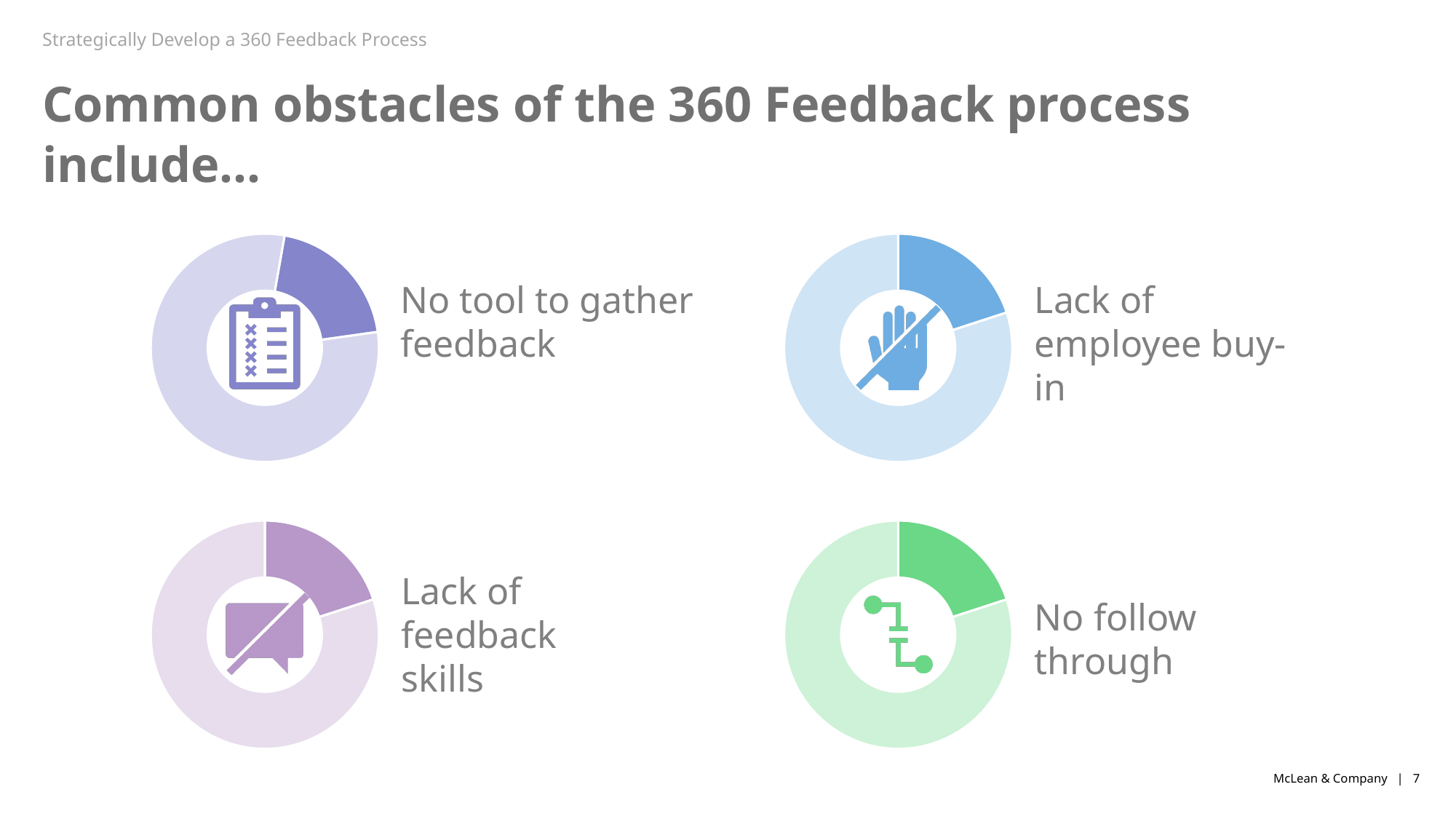
Which obstacle label is shown next to the blue doughnut chart? Lack of employee buy-in How many doughnut charts are shown on the slide? 4 What kind of chart is used next to the label "No tool to gather feedback"? Doughnut chart What kind of chart is used next to the label "No follow through"? Doughnut chart Which highlighted segment is larger: the one in the "Lack of feedback skills" chart or the one in the "No follow through" chart? Neither; they are the same size What colour is the highlighted segment of the doughnut chart next to "No follow through"? Green How many segments does the doughnut chart next to "Lack of employee buy-in" have? 2 Which highlighted segment is larger: the one in the "Lack of feedback skills" chart or the one in the "Lack of employee buy-in" chart? Neither; they are the same size